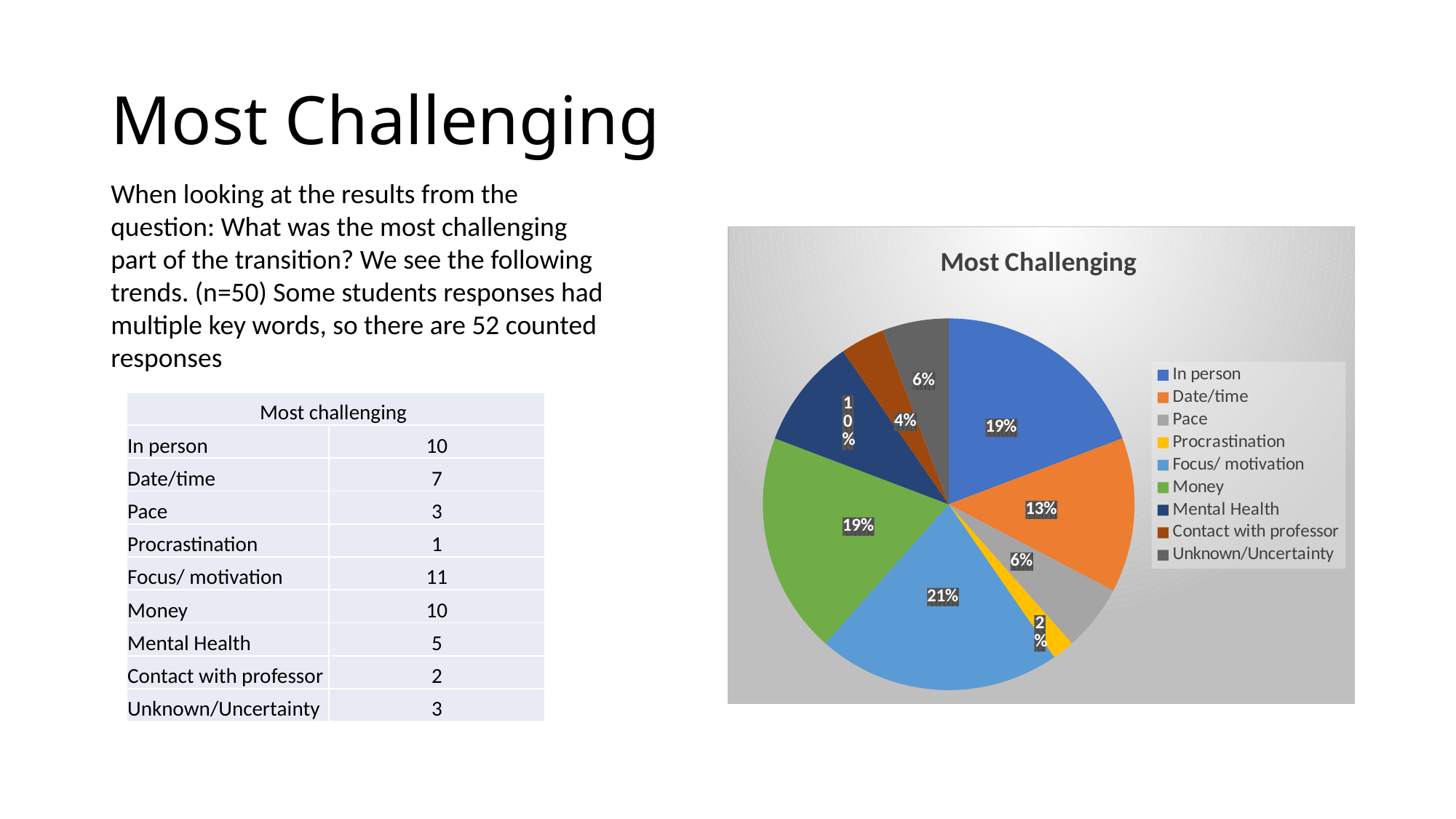
Which category has the smallest slice of the pie? Procrastination What share of the pie does Date/time take? 13% What share of the pie does Contact with professor take? 4% What kind of chart is shown on the slide? pie chart What is the difference in percentage points between the Focus/ motivation slice and the Date/time slice? 8 What colour is the Money slice in the pie chart? green What share of the pie does Mental Health take? 10% Which category has the largest slice of the pie? Focus/ motivation What is the title of the chart? Most Challenging Which slice is larger, Date/time or Mental Health? Date/time How many categories does the pie chart's legend list? 9